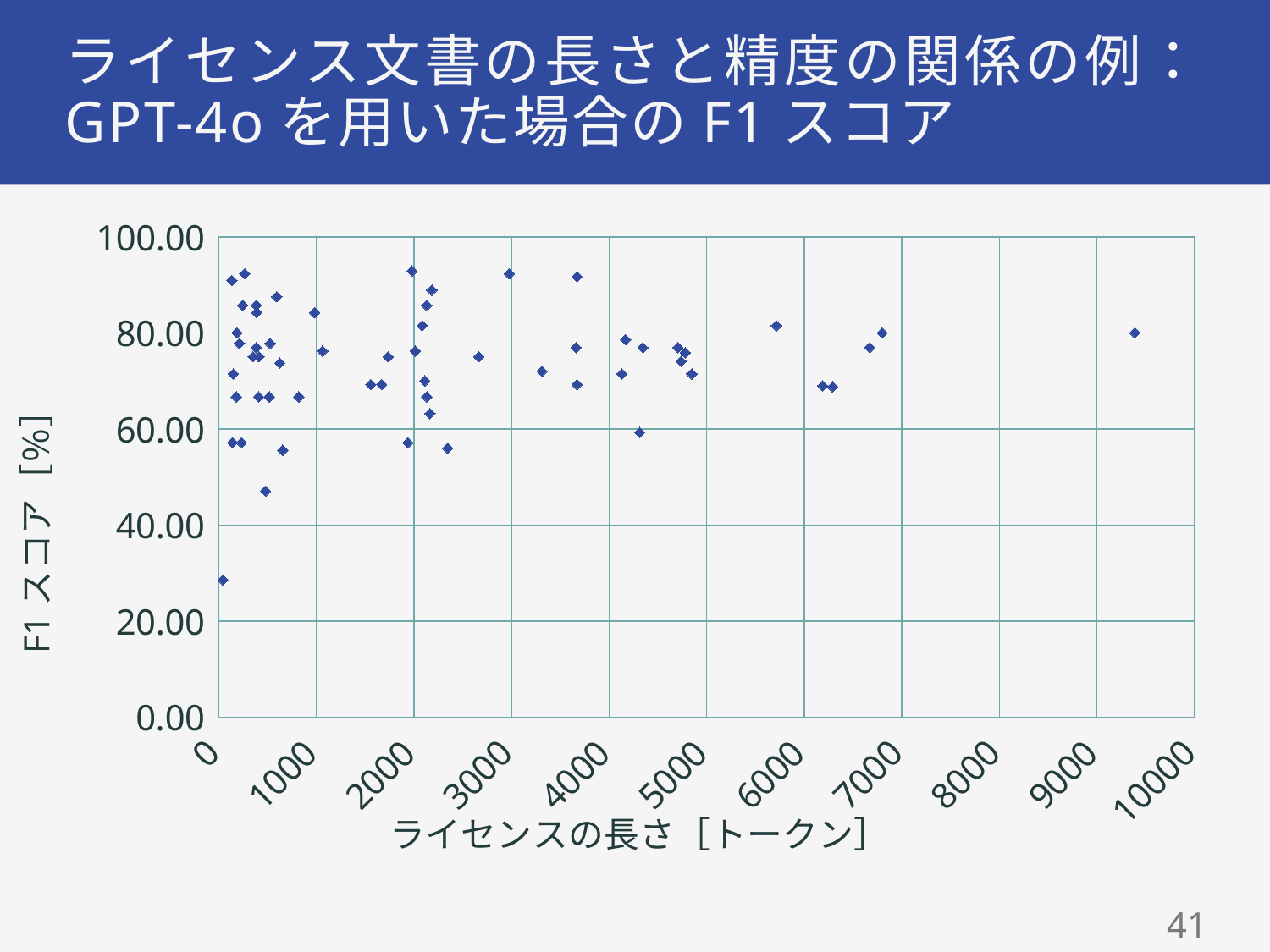
Is the license length of the lowest point on the chart greater or less than 1000 tokens? less Is the license length of the rightmost point on the chart greater or less than 9000 tokens? greater Is the F1 score of the lowest point on the chart greater or less than 40.00? less What is the label of the x axis of the chart? ライセンスの長さ［トークン］ What is the highest value shown on the y axis of the chart? 100.00 What is the label of the y axis of the chart? F1 スコア［%］ What kind of chart is shown on the slide? Scatter plot